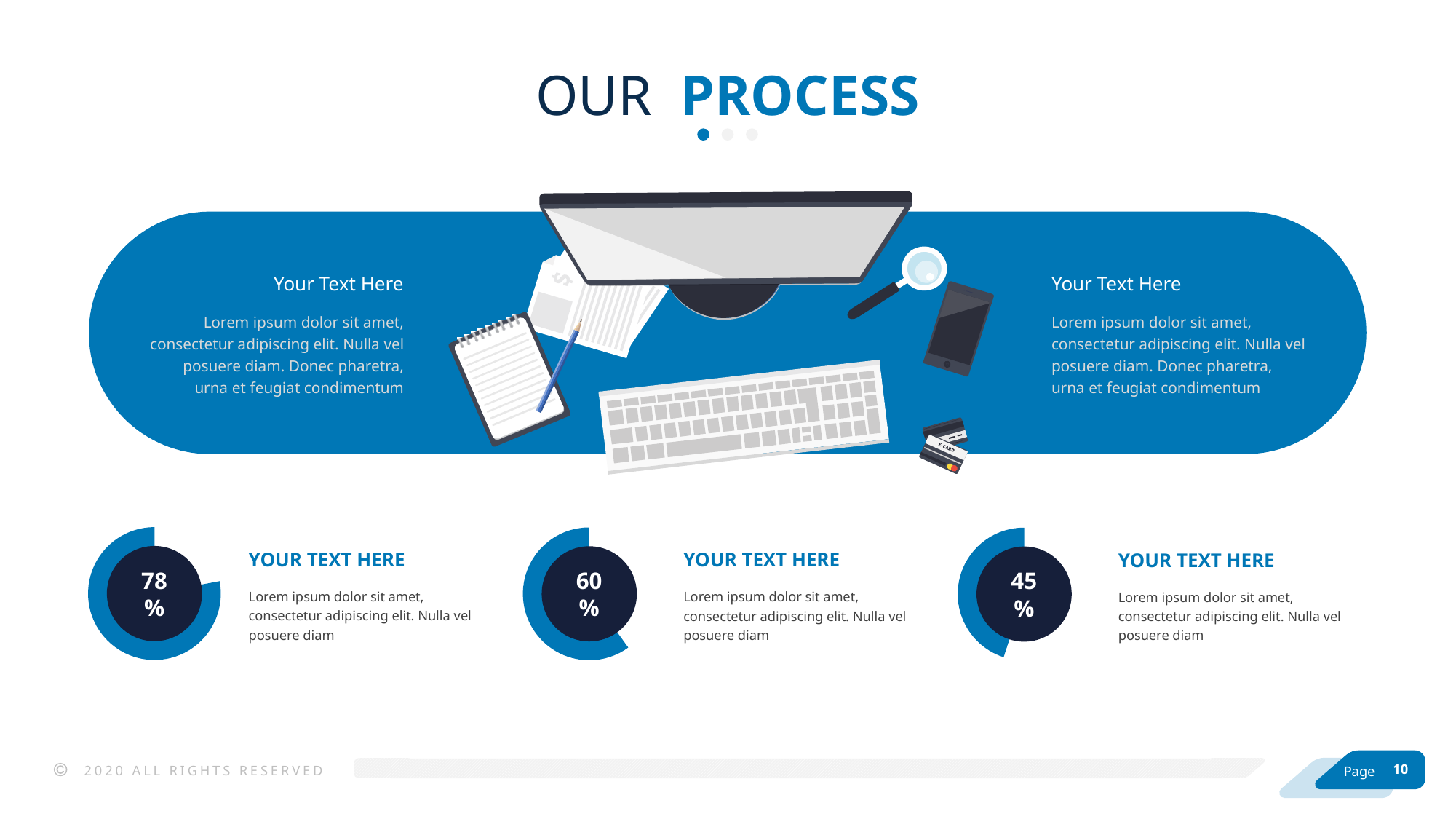
What value is shown in the centre of the middle ring chart? 60% Which of the three ring charts at the bottom of the slide shows the highest percentage? The left-hand chart (78%) What value is shown in the centre of the left-hand ring chart? 78% How many ring charts are shown at the bottom of the slide? 3 Do the percentages in the ring charts increase or decrease from left to right across the slide? Decrease What is the difference between the percentage in the left-hand ring chart and the percentage in the right-hand ring chart? 33% What value is shown in the centre of the right-hand ring chart? 45% Which is larger, the percentage in the middle ring chart or the percentage in the right-hand ring chart? The middle ring chart (60%) What kind of chart is used to display the 78%, 60% and 45% values? Ring (donut) chart What is the difference between the percentage in the left-hand ring chart and the percentage in the middle ring chart? 18% What is the title of the slide containing the three ring charts? OUR PROCESS Which of the three ring charts at the bottom of the slide shows the lowest percentage? The right-hand chart (45%)